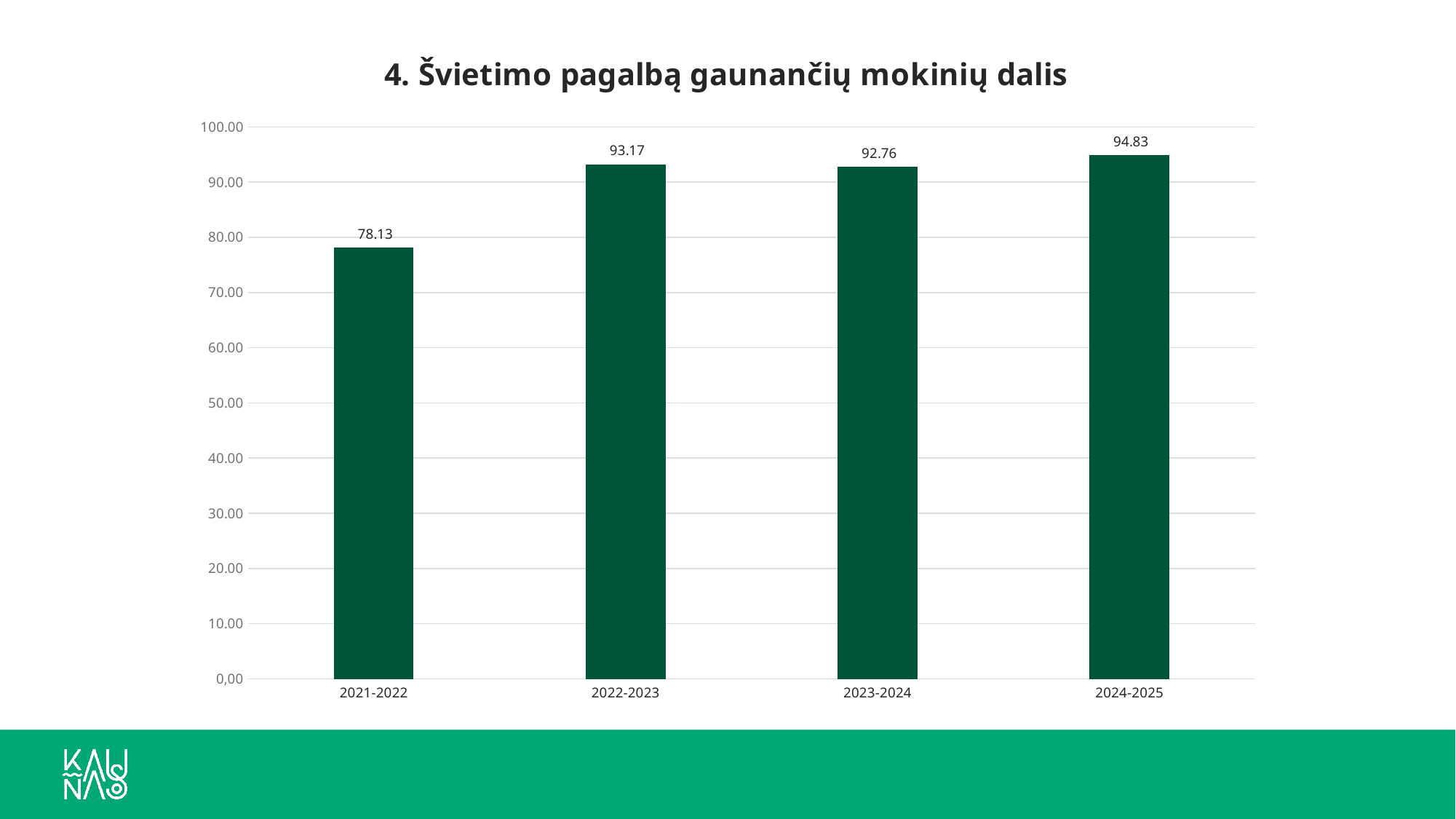
Which school year has the lowest value? 2021-2022 What is the value for 2024-2025? 94.83 What is the value for 2023-2024? 92.76 What is the value for 2022-2023? 93.17 What is the title of the chart? 4. Švietimo pagalbą gaunančių mokinių dalis What is the difference between the values for 2024-2025 and 2021-2022? 16.70 Which school year has the highest value? 2024-2025 Which is larger, the value for 2022-2023 or the value for 2023-2024? 2022-2023 What kind of chart is shown on the slide? bar chart How many school years are shown on the chart? 4 What is the value for 2021-2022? 78.13 Is the value for 2021-2022 greater or less than 80.00? less